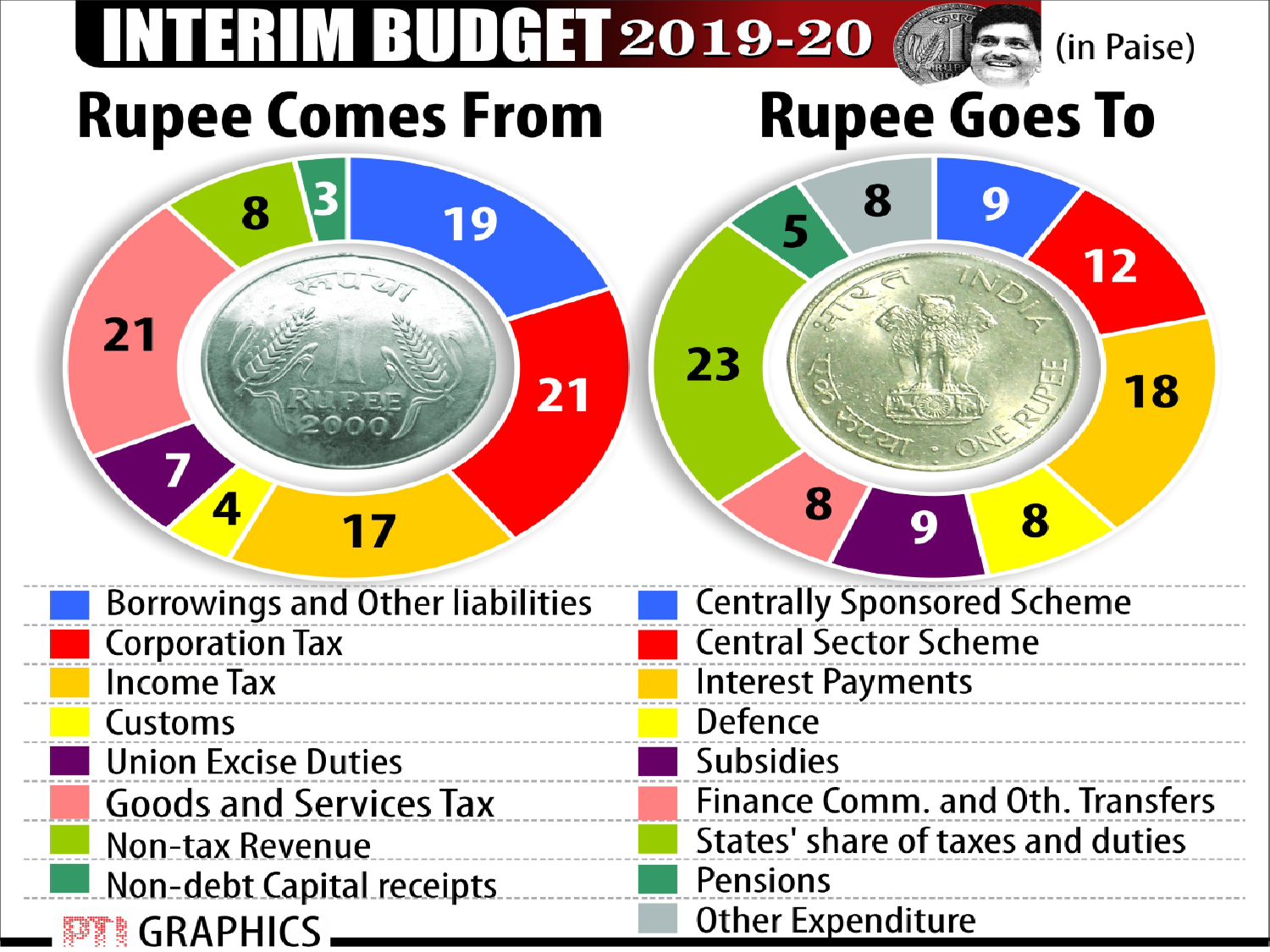
In the 'Rupee Comes From' chart, what is the value for Borrowings and Other liabilities? 19 How many categories does the 'Rupee Comes From' chart have? 8 In the 'Rupee Comes From' chart, which category has the lowest value? Non-debt Capital receipts In the 'Rupee Goes To' chart, which category has the highest value? States' share of taxes and duties What kind of chart is the 'Rupee Comes From' chart? Donut (pie) chart How many categories does the 'Rupee Goes To' chart have? 9 In the 'Rupee Goes To' chart, what is the value for Central Sector Scheme? 12 In the 'Rupee Comes From' chart, what is the difference between Corporation Tax and Customs? 17 In the 'Rupee Comes From' chart, what is the value for Income Tax? 17 In the 'Rupee Goes To' chart, which category has the lowest value? Pensions In the 'Rupee Goes To' chart, what is the value for Interest Payments? 18 In the 'Rupee Goes To' chart, which is larger, Subsidies or Pensions? Subsidies